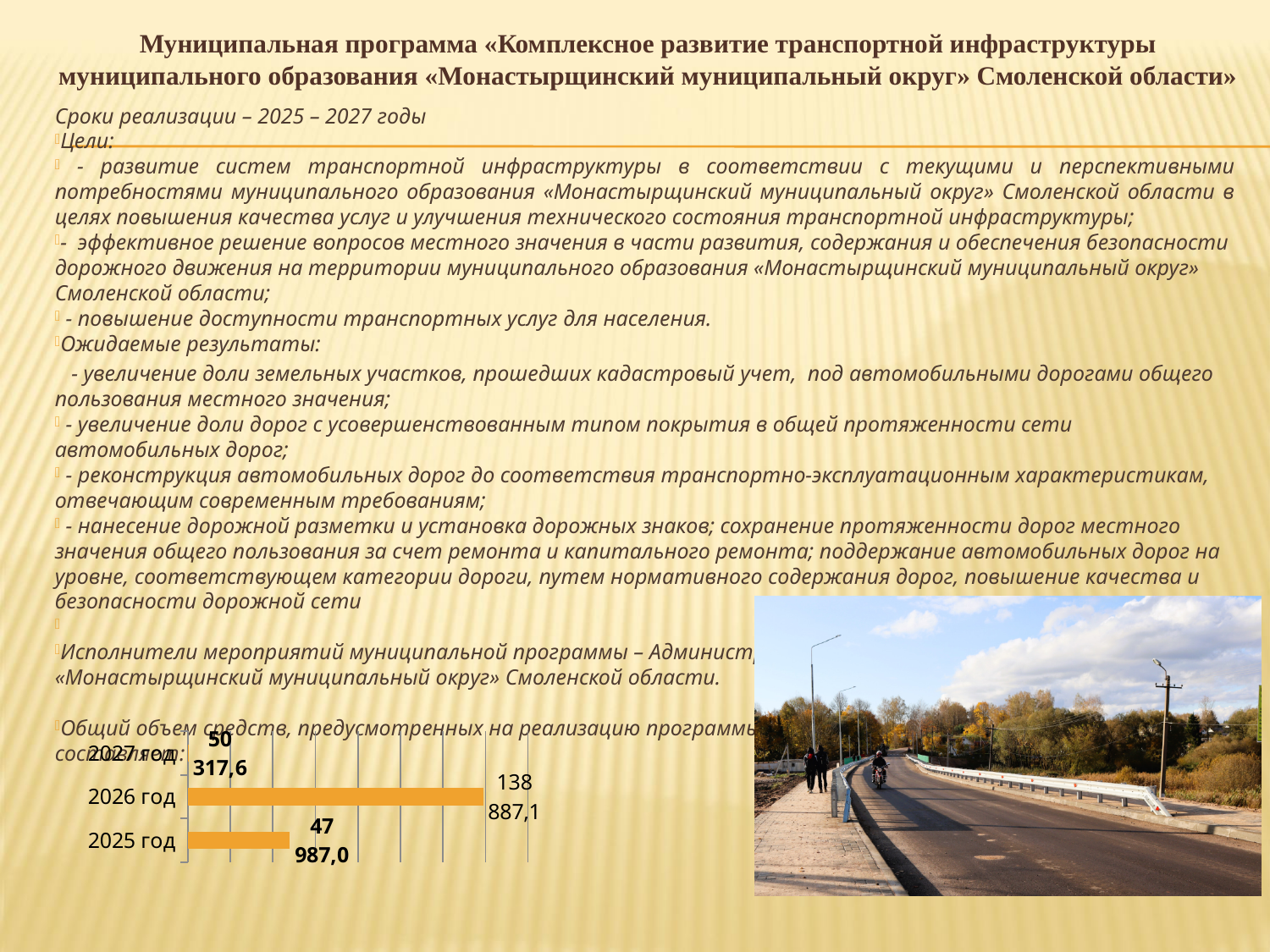
What is the sum of the values for all three years on the bar chart? 237 191,7 What is the value shown for 2025 год on the bar chart? 47 987,0 Which is larger on the bar chart: the value for 2026 год or the value for 2025 год? 2026 год What is the value shown for 2027 год on the bar chart? 50 317,6 Which year has the highest value on the bar chart? 2026 год What is the value shown for 2026 год on the bar chart? 138 887,1 What is the difference between the values for 2026 год and 2027 год on the bar chart? 88 569,5 What is the difference between the values for 2027 год and 2025 год on the bar chart? 2 330,6 How many years (categories) are shown on the bar chart? 3 What colour are the bars on the chart? Orange What kind of chart is shown on the slide? Bar chart